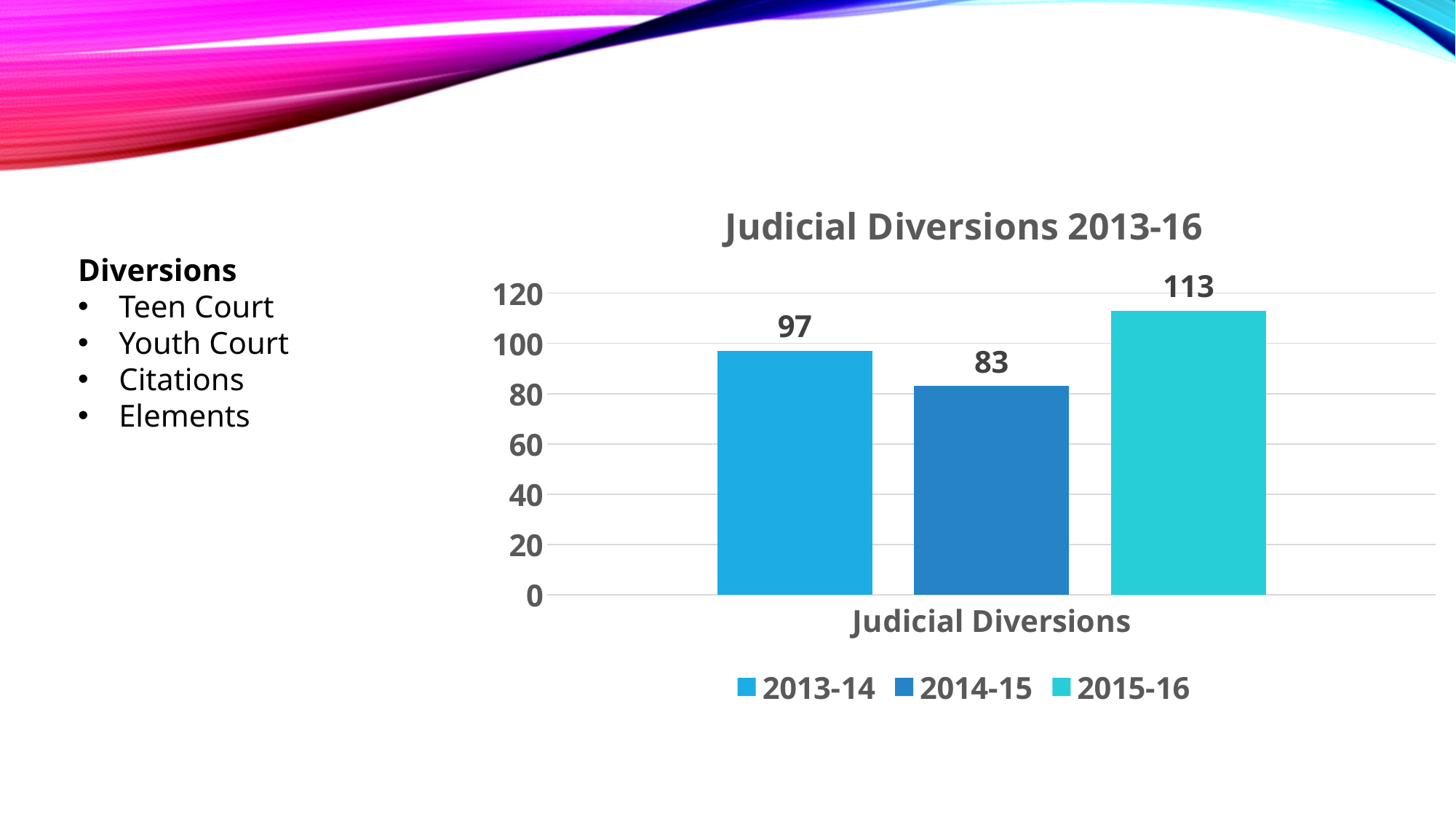
What is the value for 2014-15 in the Judicial Diversions 2013-16 chart? 83 What is the value for 2015-16 in the Judicial Diversions 2013-16 chart? 113 Is the value for 2014-15 in the Judicial Diversions 2013-16 chart greater or less than 100? less What is the difference between the 2013-14 and 2014-15 values in the Judicial Diversions 2013-16 chart? 14 What is the title of the chart on the slide? Judicial Diversions 2013-16 Which is larger in the Judicial Diversions 2013-16 chart, the value for 2013-14 or the value for 2015-16? 2015-16 What is the value for 2013-14 in the Judicial Diversions 2013-16 chart? 97 What kind of chart is the Judicial Diversions 2013-16 chart? bar chart How many series does the legend list in the Judicial Diversions 2013-16 chart? 3 Which year has the lowest value in the Judicial Diversions 2013-16 chart? 2014-15 Which year has the highest value in the Judicial Diversions 2013-16 chart? 2015-16 What is the difference between the 2015-16 and 2014-15 values in the Judicial Diversions 2013-16 chart? 30